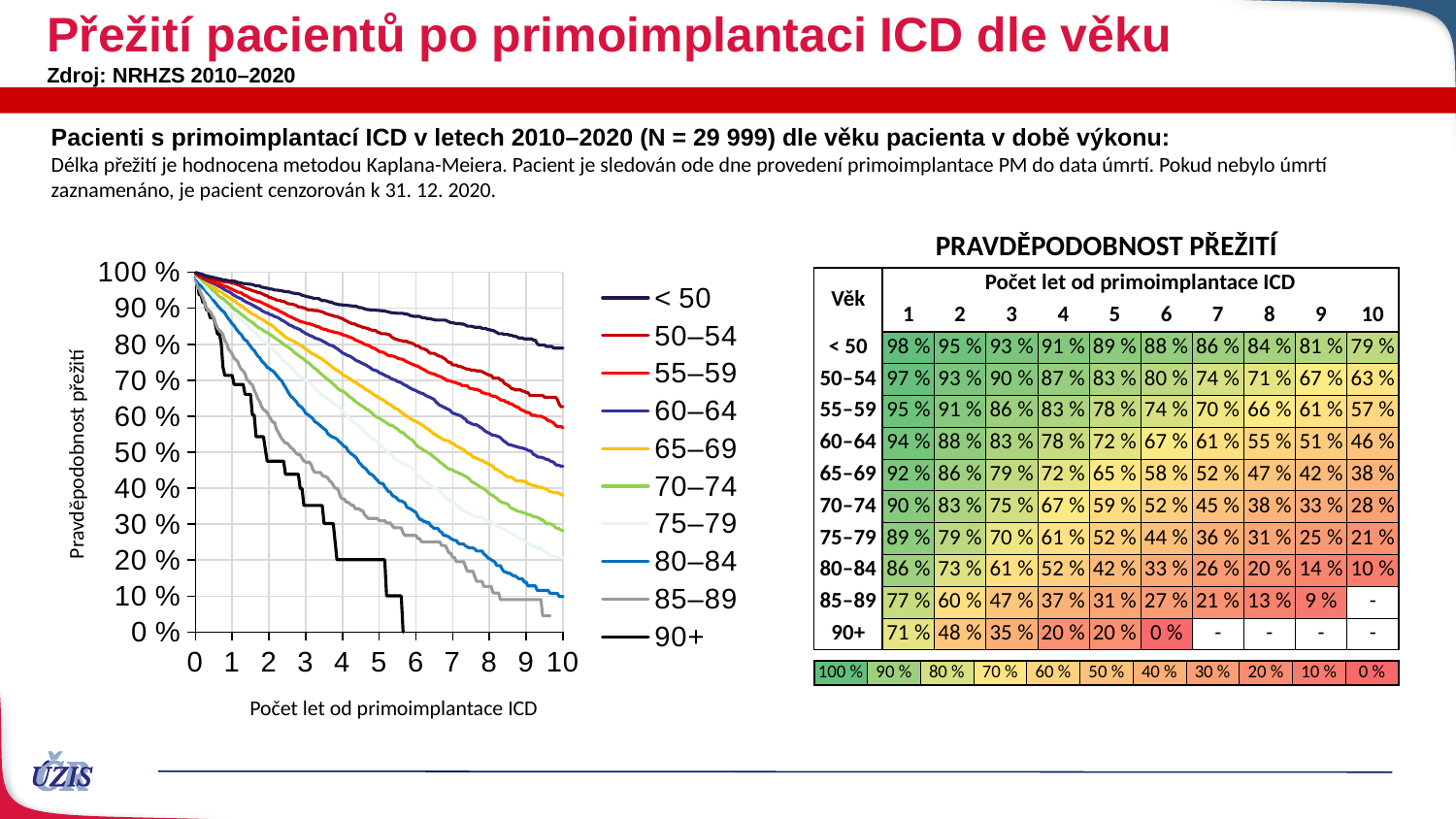
In the line chart, is the survival probability for the < 50 group at 10 years greater or less than 70 %? greater What kind of chart is shown on the left of the slide? line chart In the table 'Pravděpodobnost přežití', which group has the higher 5-year survival probability, 60–64 or 65–69? 60–64 In the line chart, is the survival probability for the 90+ group at 4 years greater or less than 50 %? less According to the table 'Pravděpodobnost přežití', what is the survival probability for the < 50 group 10 years after implantation? 79 % In the table 'Pravděpodobnost přežití', what is the difference between the 1-year survival of the 50–54 group and the 85–89 group? 20 % How many age-group series does the legend of the line chart list? 10 According to the table 'Pravděpodobnost přežití', what is the survival probability for the 90+ group 1 year after implantation? 71 % In the table 'Pravděpodobnost přežití', which age group has the lowest survival probability at 5 years? 90+ In the line chart, do the survival curves rise or fall as the number of years since implantation increases? fall In the table 'Pravděpodobnost přežití', which age group has the highest survival probability at 10 years? < 50 According to the table 'Pravděpodobnost přežití', what is the survival probability for the 70–74 group 5 years after implantation? 59 %